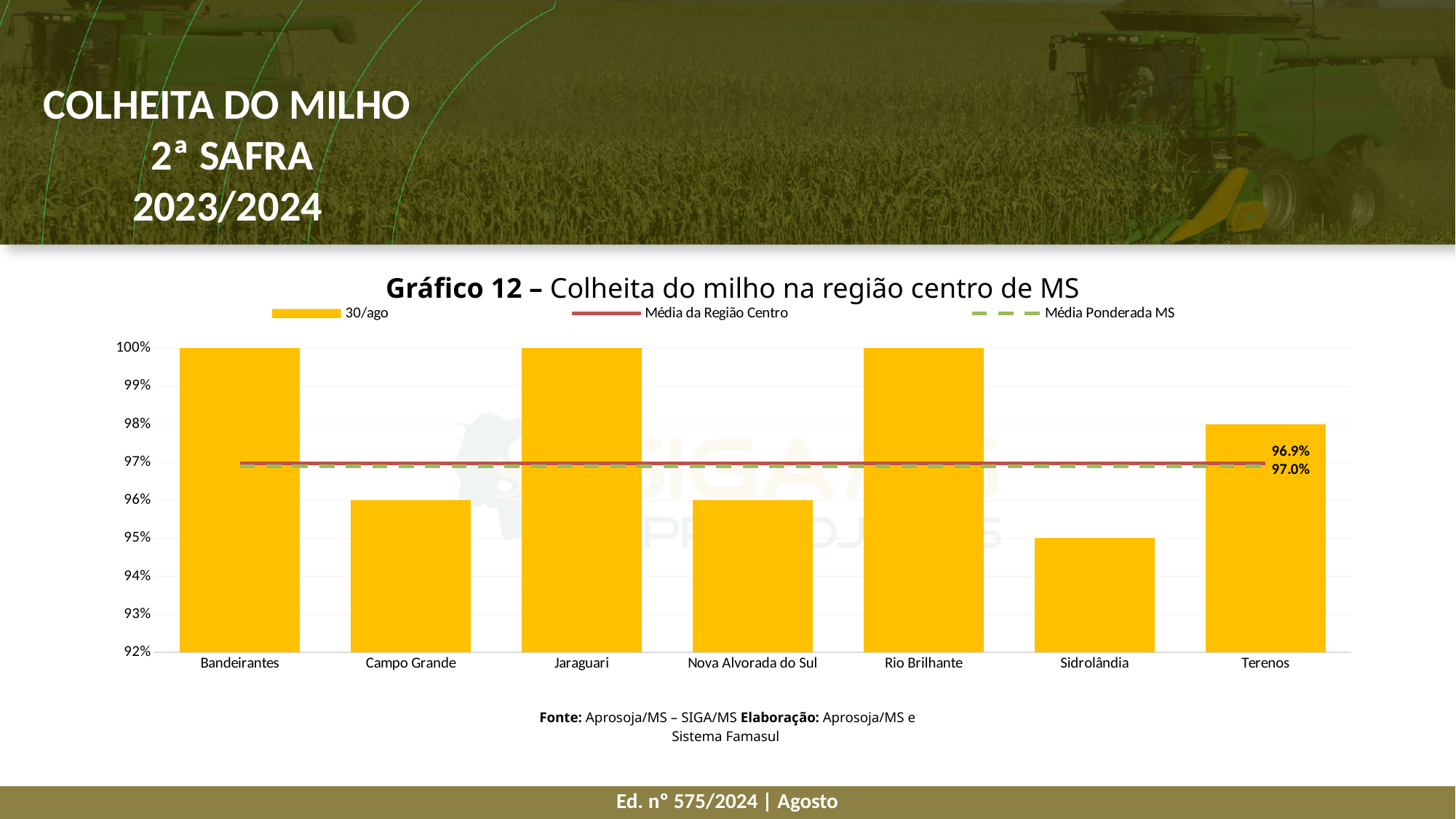
What is the harvest value for Terenos? 98% Which is larger, the value for Terenos or the value for Campo Grande? Terenos Which municipality has the lowest harvest value? Sidrolândia What is the harvest value for Rio Brilhante? 100% How many series does the legend list? 3 How many municipalities are shown on the x axis? 7 What kind of chart is Gráfico 12? bar chart What is the difference between the values for Terenos and Sidrolândia? 3 percentage points Is the value for Nova Alvorada do Sul greater or less than 97%? less What is the harvest value for Campo Grande? 96% How many municipalities reach 100%? 3 What is the harvest value for Sidrolândia? 95%